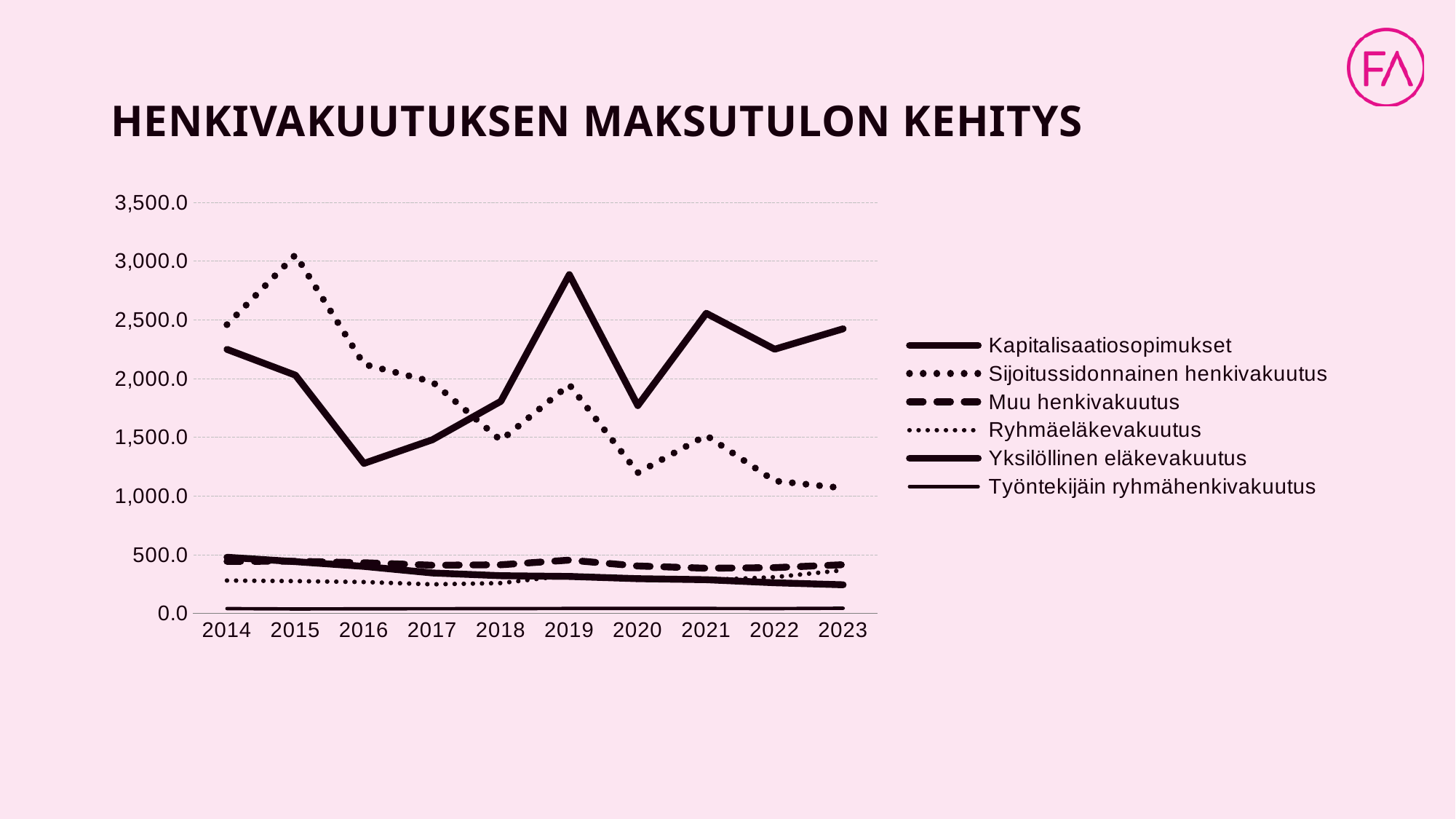
Is the value for Kapitalisaatiosopimukset in 2016 greater or less than 1,500.0? less In 2015, which is larger: Sijoitussidonnainen henkivakuutus or Kapitalisaatiosopimukset? Sijoitussidonnainen henkivakuutus Is the value for Kapitalisaatiosopimukset in 2019 greater or less than 2,500.0? greater What kind of chart is shown on the slide? line chart In which year does Kapitalisaatiosopimukset reach its highest value? 2019 In which year does Sijoitussidonnainen henkivakuutus reach its highest value? 2015 In 2023, which is larger: Kapitalisaatiosopimukset or Sijoitussidonnainen henkivakuutus? Kapitalisaatiosopimukset Is the value for Sijoitussidonnainen henkivakuutus in 2015 greater or less than 2,500.0? greater Which series has the lowest values across all years? Työntekijäin ryhmähenkivakuutus How many years are shown on the x axis? 10 How many series does the legend list? 6